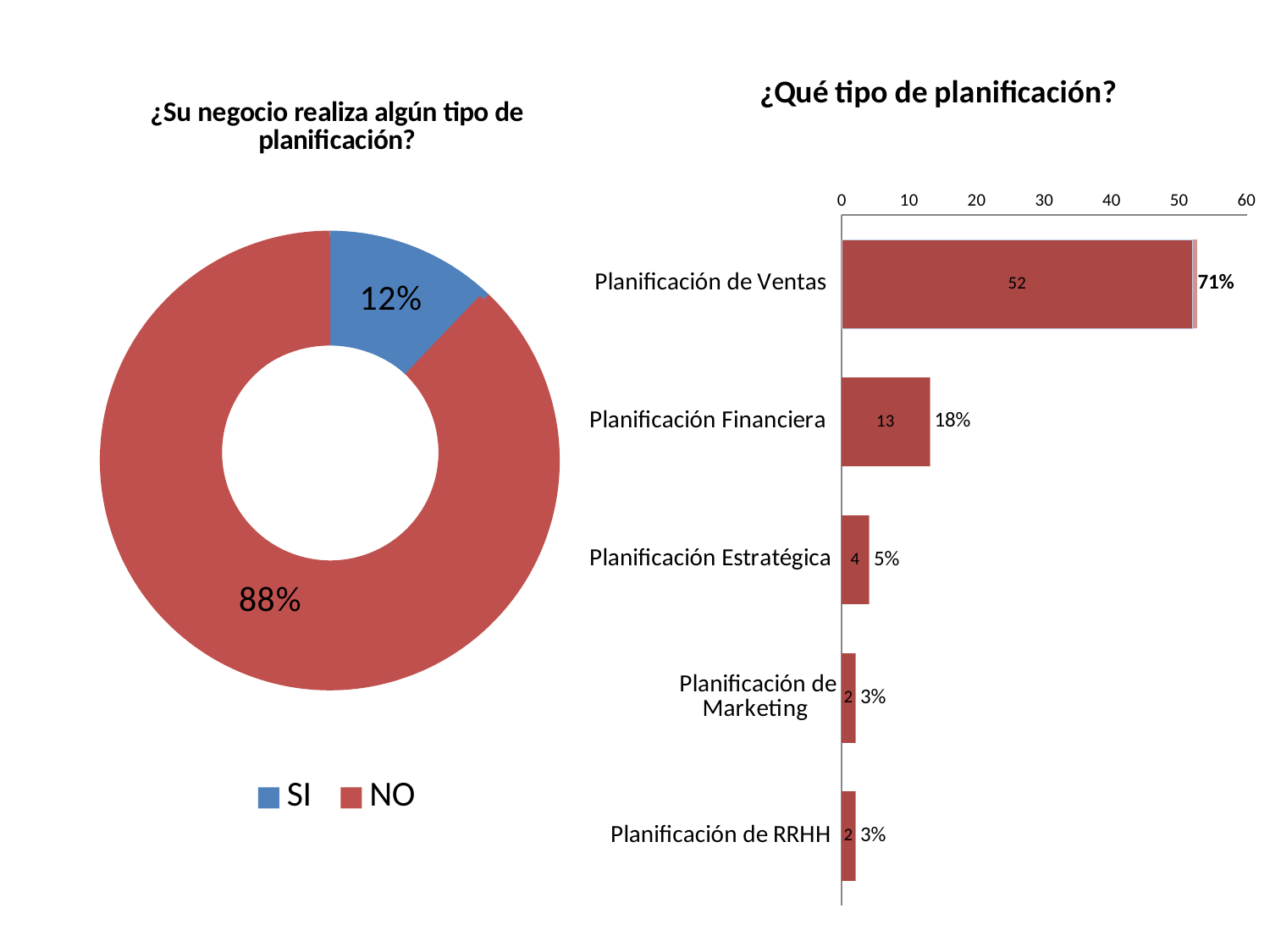
In the chart titled '¿Su negocio realiza algún tipo de planificación?', what share of the pie is 'NO'? 88% In the chart titled '¿Qué tipo de planificación?', what is the value for 'Planificación Financiera'? 13 What kind of chart is the one titled '¿Qué tipo de planificación?'? Bar chart In the chart titled '¿Su negocio realiza algún tipo de planificación?', what colour is the 'SI' slice? Blue In the chart titled '¿Su negocio realiza algún tipo de planificación?', what share of the pie is 'SI'? 12% In the chart titled '¿Su negocio realiza algún tipo de planificación?', how many entries does the legend list? 2 In the chart titled '¿Qué tipo de planificación?', what is the difference between the values for 'Planificación de Ventas' and 'Planificación Financiera'? 39 In the chart titled '¿Qué tipo de planificación?', which is larger, the value for 'Planificación Financiera' or 'Planificación Estratégica'? Planificación Financiera In the chart titled '¿Qué tipo de planificación?', which category has the highest value? Planificación de Ventas In the chart titled '¿Qué tipo de planificación?', what is the value for 'Planificación de Ventas'? 52 In the chart titled '¿Qué tipo de planificación?', what percentage is shown next to 'Planificación Estratégica'? 5% In the chart titled '¿Qué tipo de planificación?', how many categories are shown? 5